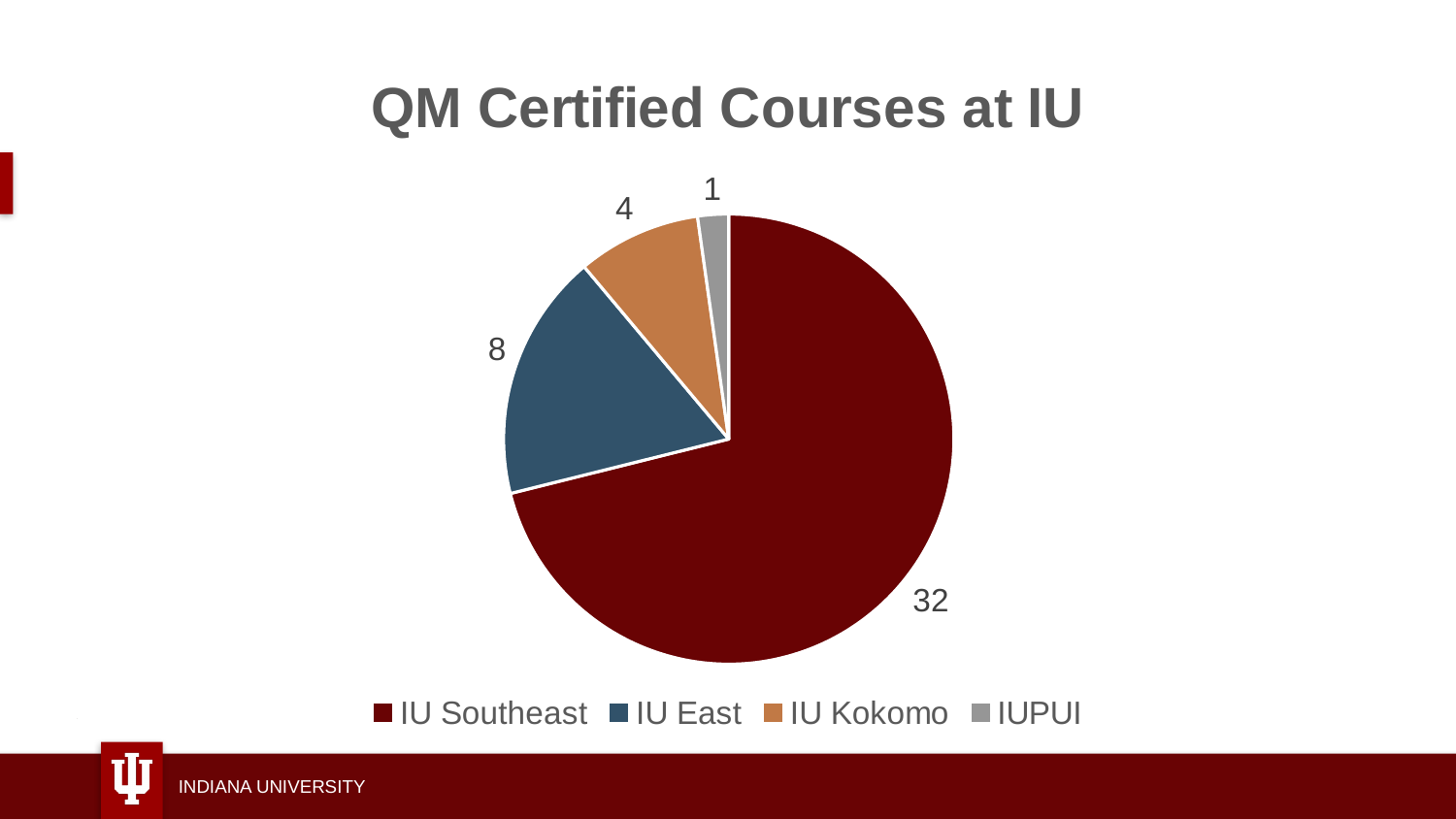
How many campuses are shown in the pie chart? 4 Which campus has the most QM certified courses? IU Southeast How many QM certified courses does IU Kokomo have? 4 What type of chart is shown on the slide? Pie chart What is the title of the chart? QM Certified Courses at IU How many QM certified courses does IU Southeast have? 32 How many QM certified courses does IUPUI have? 1 What is the total number of QM certified courses across all campuses shown? 45 Which has more QM certified courses, IU East or IU Kokomo? IU East How many more QM certified courses does IU Southeast have than IU East? 24 How many QM certified courses does IU East have? 8 Which campus has the fewest QM certified courses? IUPUI